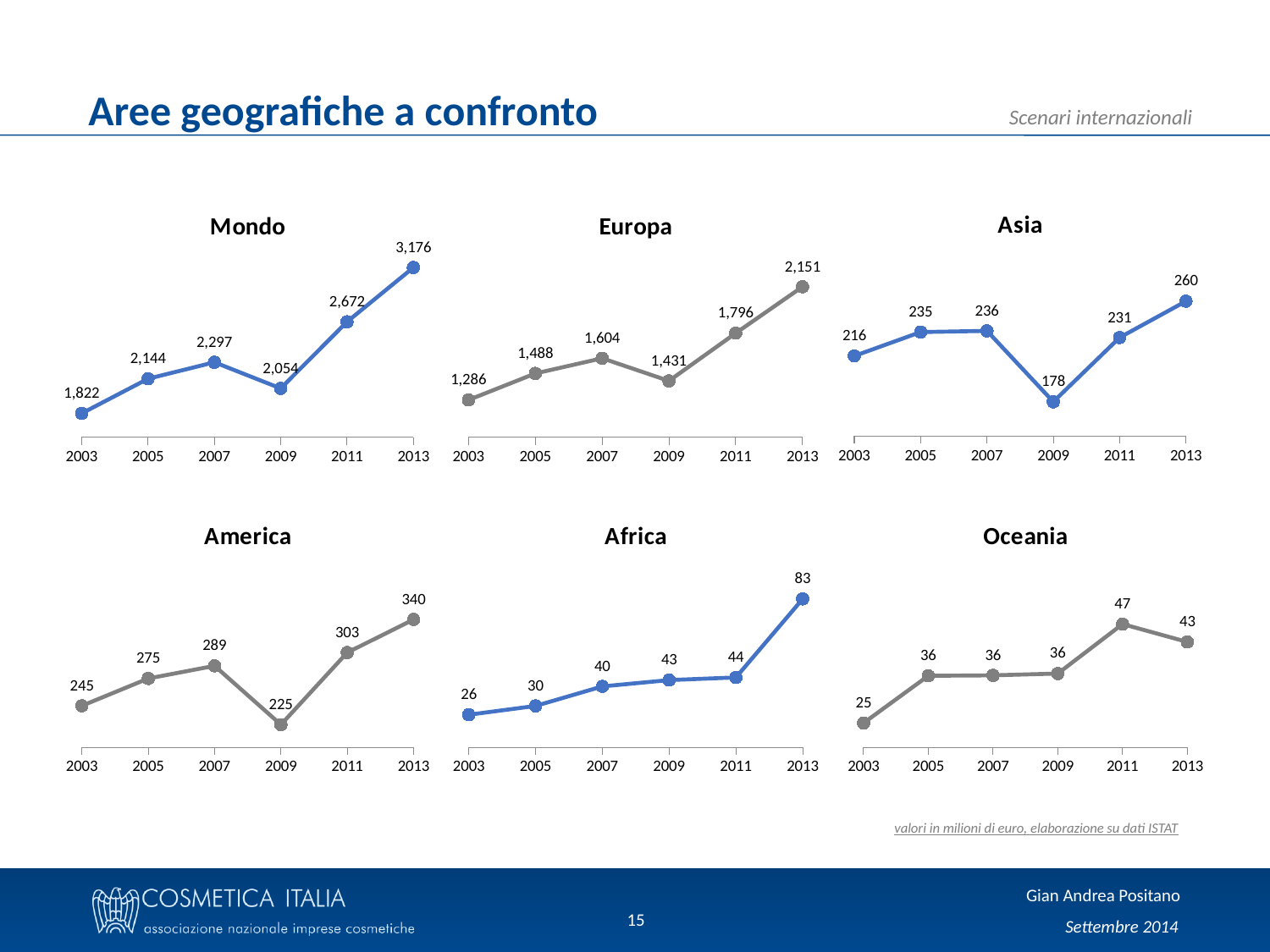
In the Oceania chart, is the value for 2011 larger or smaller than the value for 2013? larger In the Mondo chart, what is the value for 2013? 3,176 In the America chart, what is the difference between the 2013 value and the 2003 value? 95 In the Africa chart, which year has the highest value? 2013 In the Asia chart, what is the difference between the 2013 value and the 2009 value? 82 In the Europa chart, what is the value for 2009? 1,431 In the Africa chart, do the values rise or fall from 2003 to 2013? rise What kind of chart is the Europa chart? line chart How many charts are shown on the slide? 6 How many data points are plotted in the Mondo chart? 6 In the Europa chart, what is the value for 2011? 1,796 In the Asia chart, which year has the lowest value? 2009